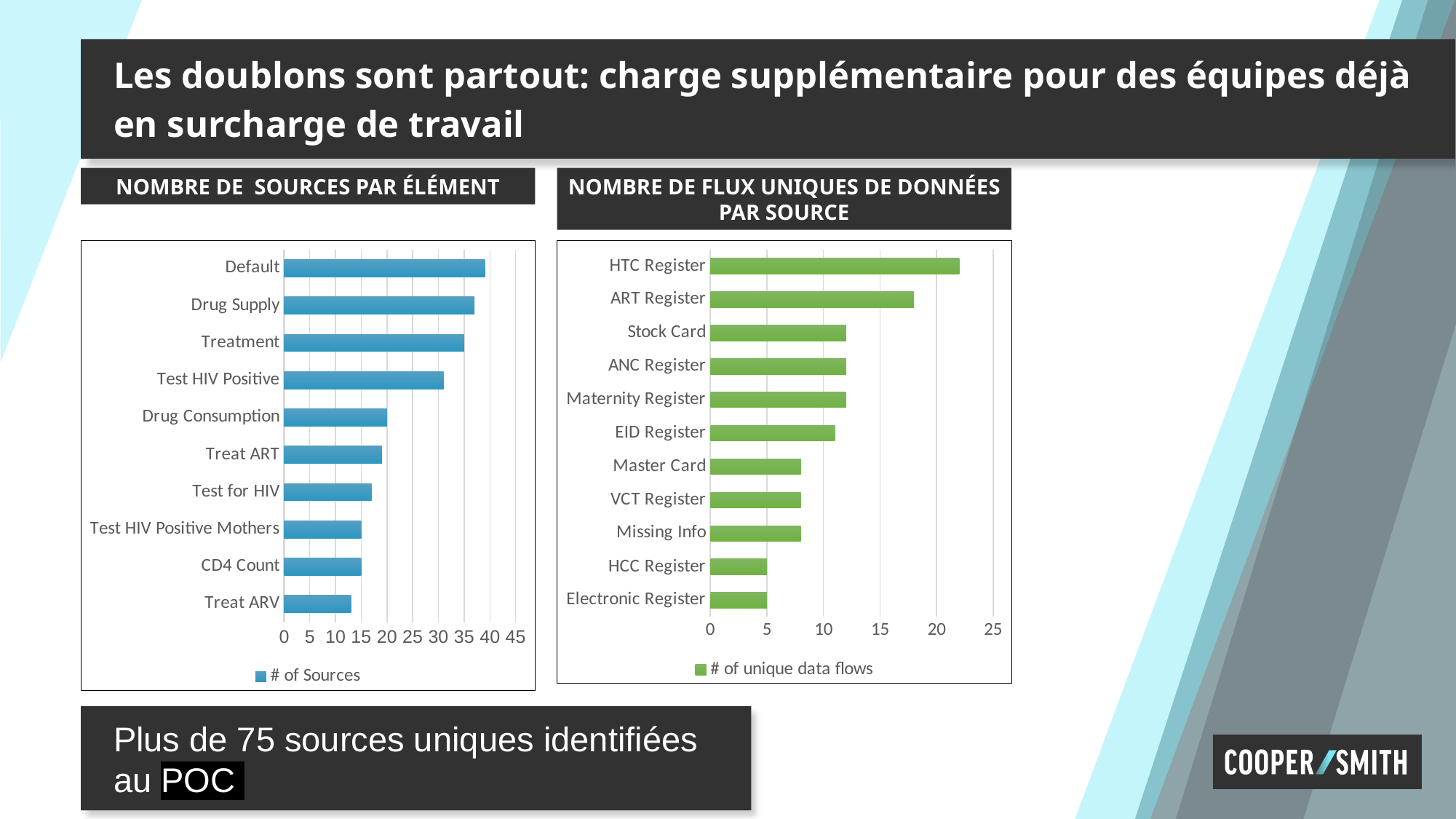
In the 'NOMBRE DE SOURCES PAR ÉLÉMENT' chart, which is larger, Drug Supply or Drug Consumption? Drug Supply In the 'NOMBRE DE SOURCES PAR ÉLÉMENT' chart, which category has the highest number of sources? Default In the 'NOMBRE DE SOURCES PAR ÉLÉMENT' chart, how many categories are shown? 10 In the 'NOMBRE DE FLUX UNIQUES DE DONNÉES PAR SOURCE' chart, is the value for HTC Register greater or less than 20? greater In the 'NOMBRE DE SOURCES PAR ÉLÉMENT' chart, is the value for Default greater or less than 35? greater In the 'NOMBRE DE FLUX UNIQUES DE DONNÉES PAR SOURCE' chart, how many series does the legend list? 1 In the 'NOMBRE DE FLUX UNIQUES DE DONNÉES PAR SOURCE' chart, how many categories are shown? 11 What kind of chart is the 'NOMBRE DE SOURCES PAR ÉLÉMENT' chart? bar chart In the 'NOMBRE DE FLUX UNIQUES DE DONNÉES PAR SOURCE' chart, which source has the highest number of unique data flows? HTC Register In the 'NOMBRE DE FLUX UNIQUES DE DONNÉES PAR SOURCE' chart, is the value for Master Card greater or less than 10? less In the 'NOMBRE DE SOURCES PAR ÉLÉMENT' chart, what is the legend entry? # of Sources